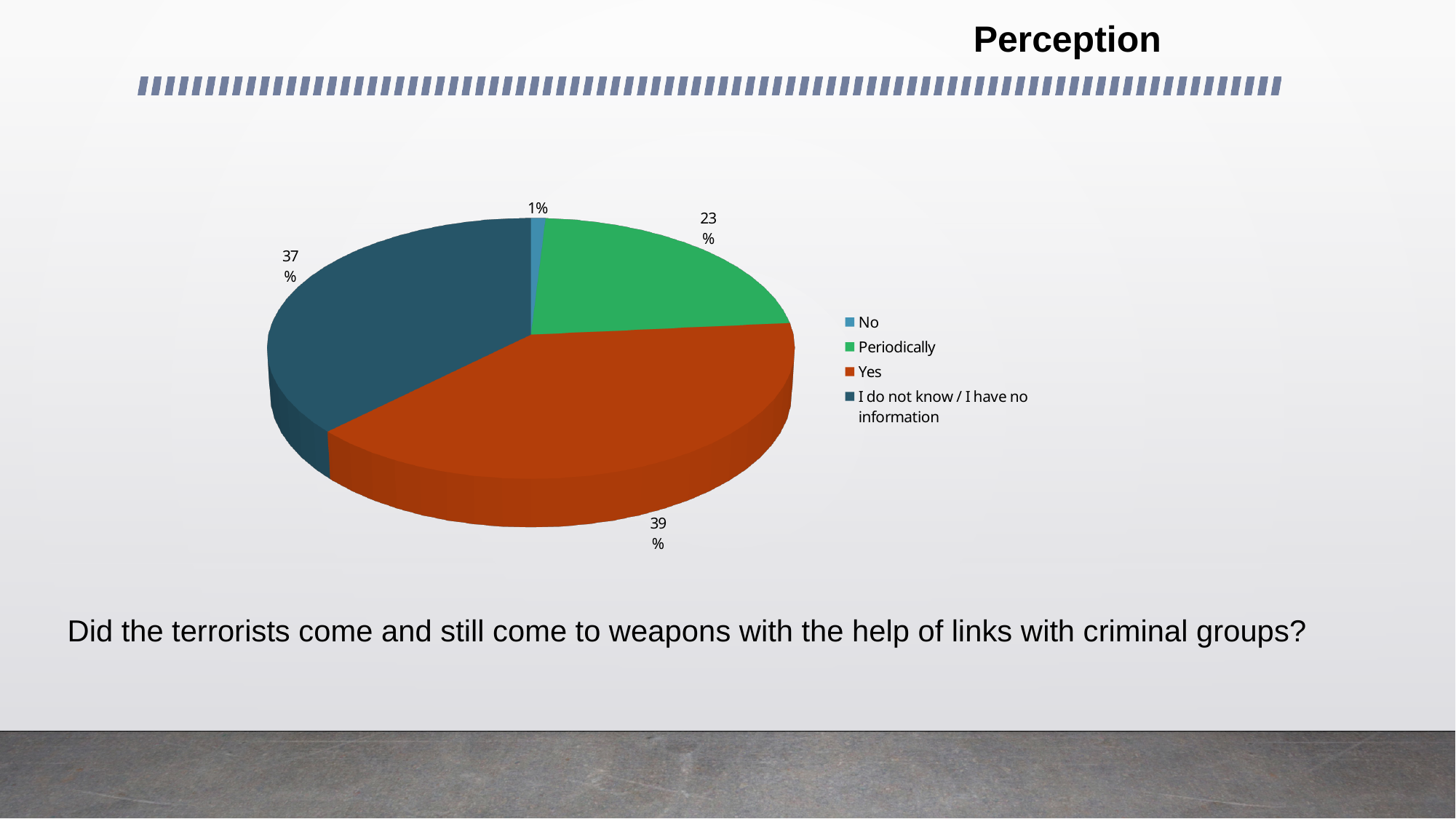
Which response has the smallest share of the pie? No How many slices does the pie chart have? 4 Which is larger, the share for "Periodically" or the share for "I do not know / I have no information"? I do not know / I have no information What colour is the "Yes" slice in the pie chart? Red-orange What is the difference in percentage points between "Yes" and "Periodically"? 16 What percentage of respondents answered "I do not know / I have no information"? 37% What percentage of respondents answered "No"? 1% What percentage of respondents answered "Periodically"? 23% Which response has the largest share of the pie? Yes What kind of chart is shown on the slide? Pie chart What percentage of respondents answered "Yes"? 39% How many entries does the legend list? 4